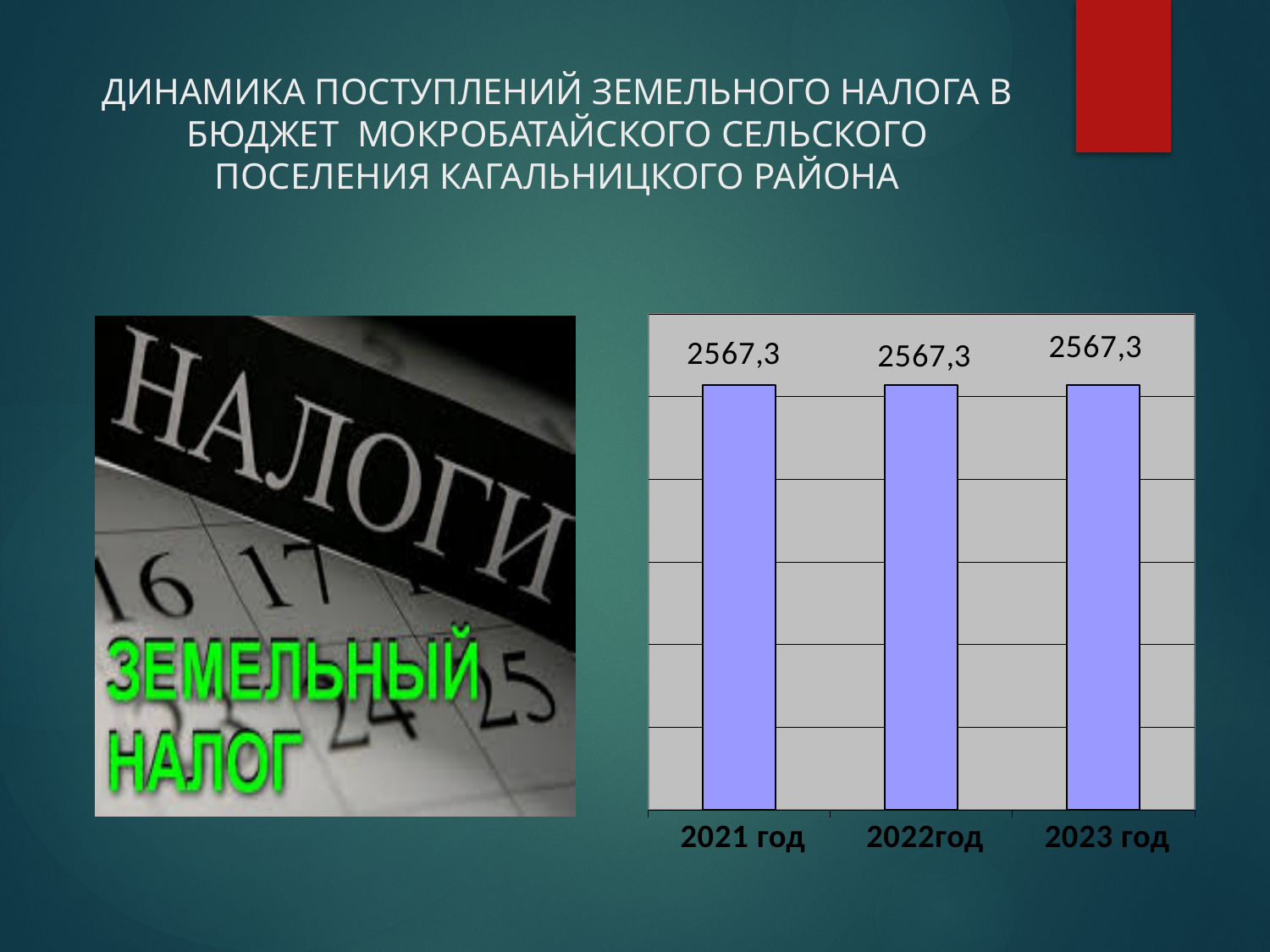
Do the values rise, fall or stay the same from 2021 год to 2023 год? Stay the same What kind of chart is shown on the slide? Bar chart What is the value for 2022год? 2567,3 How many bars (categories) are shown in the chart? 3 What is the value for 2023 год? 2567,3 What is the value for 2021 год? 2567,3 Which years are shown on the x axis of the chart? 2021 год, 2022год, 2023 год What colour are the bars in the chart? Light blue (periwinkle) Is the value for 2022год larger than, smaller than, or equal to the value for 2021 год? Equal What is the difference between the values for 2023 год and 2021 год? 0